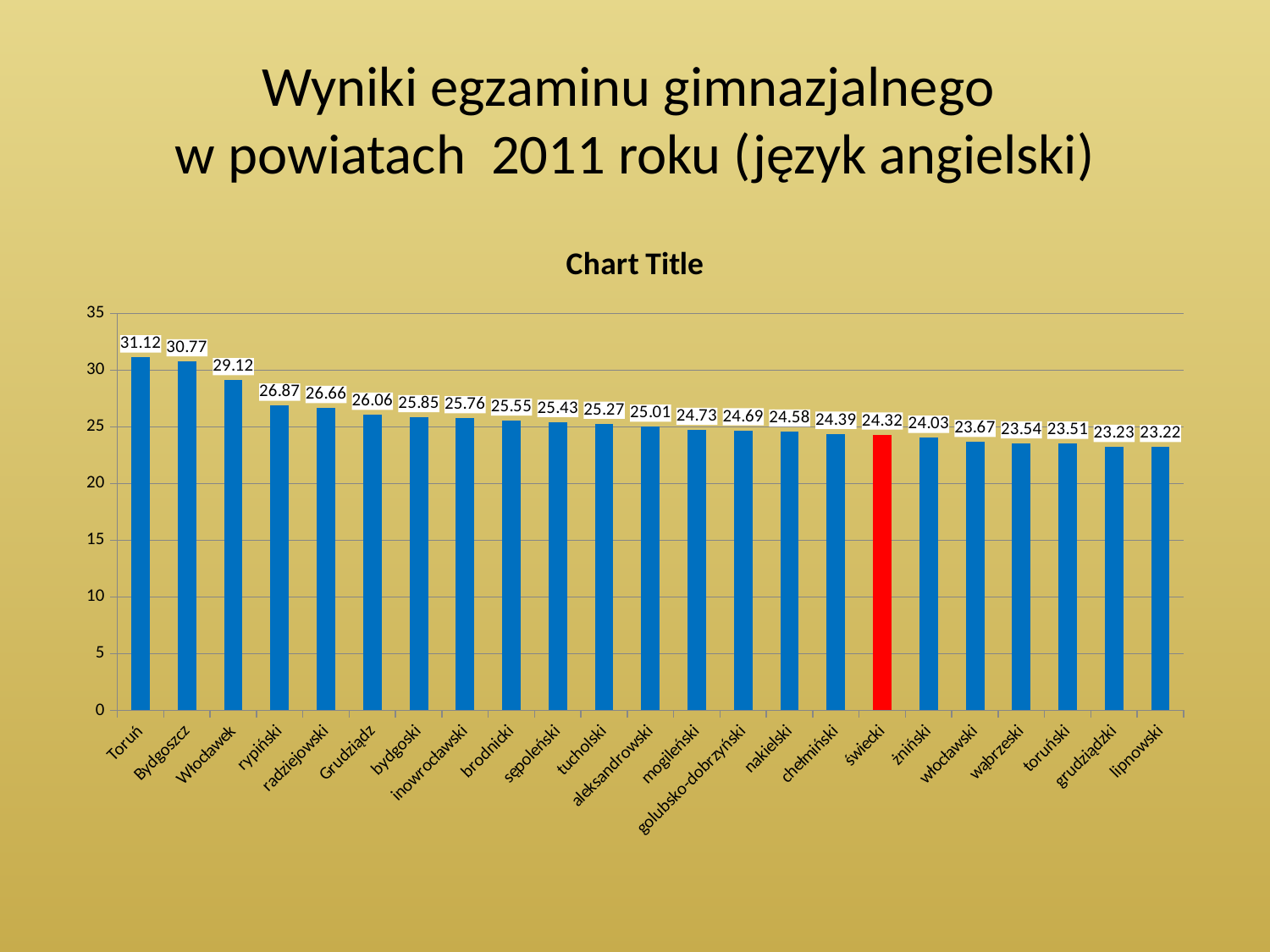
What is the difference between the values for Włocławek and włocławski? 5.45 Is the value for Bydgoszcz greater or less than 30? greater What is the difference between the values for Toruń and Bydgoszcz? 0.35 Which category has the highest value? Toruń What is the value for Toruń? 31.12 Which is larger, the value for rypiński or the value for radziejowski? rypiński Which category's bar is coloured red instead of blue? świecki What is the value for Grudziądz? 26.06 Which category has the lowest value? lipnowski How many categories are shown on the x axis? 23 What kind of chart is shown on the slide? bar chart What is the value for świecki? 24.32